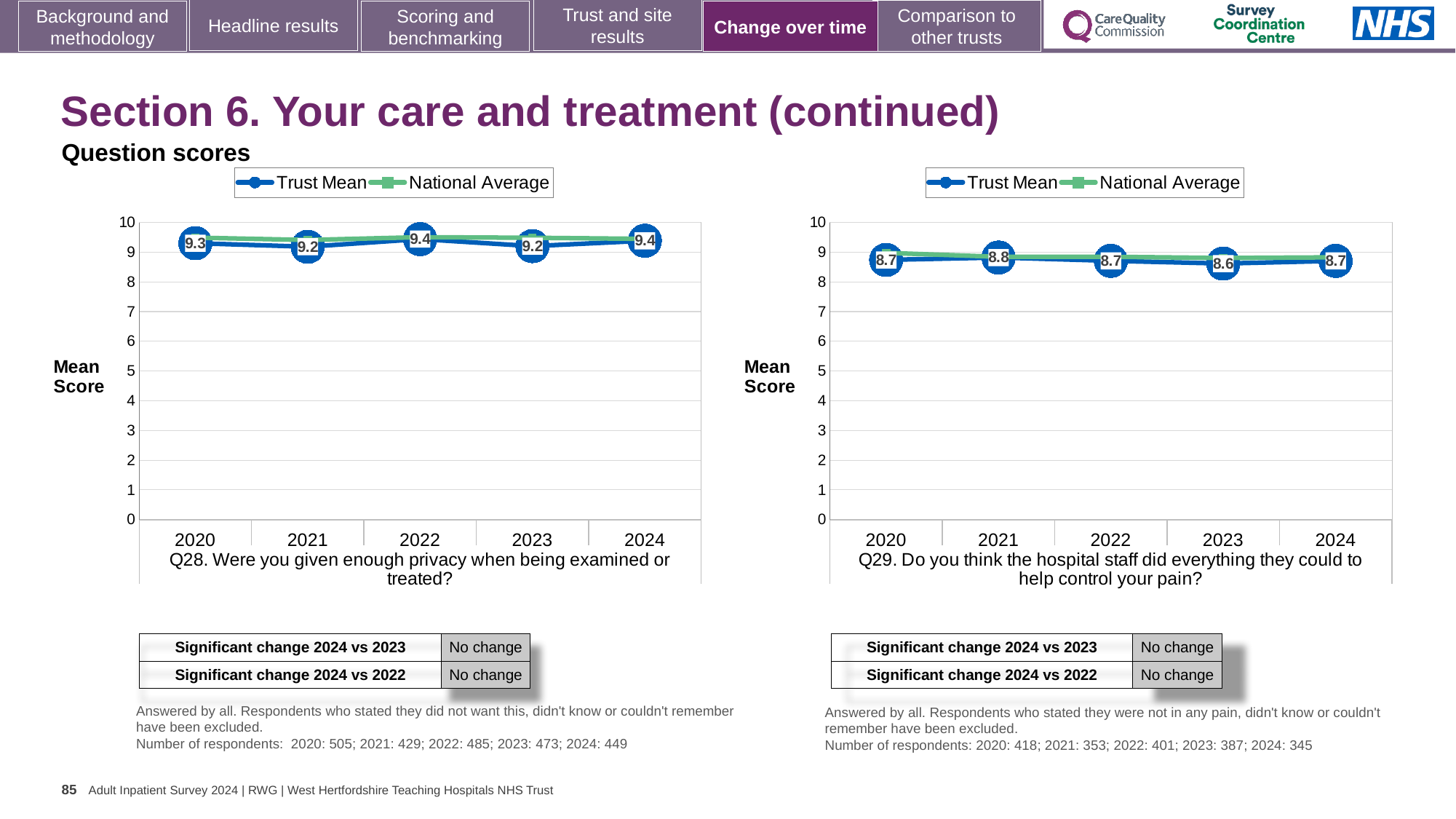
In the Q28 chart on the left, what is the difference between the Trust Mean scores for 2022 and 2021? 0.2 In the Q28 chart on the left, is the Trust Mean score for 2022 larger or smaller than the score for 2023? larger In the Q29 chart on the right, which year has the lowest Trust Mean score? 2023 In the Q28 chart on the left, what is the Trust Mean score for 2020? 9.3 How many years are plotted on the x axis of the Q28 chart on the left? 5 How many series does the legend of the Q29 chart on the right list? 2 In the Q29 chart on the right, what is the Trust Mean score for 2023? 8.6 In the Q29 chart on the right, which year has the highest Trust Mean score? 2021 In the Q28 chart on the left, what is the Trust Mean score for 2024? 9.4 In the Q29 chart on the right, what is the Trust Mean score for 2021? 8.8 In the Q29 chart on the right, what is the difference between the Trust Mean scores for 2021 and 2023? 0.2 In the Q29 chart on the right, is the National Average value for 2020 greater or less than 8? greater